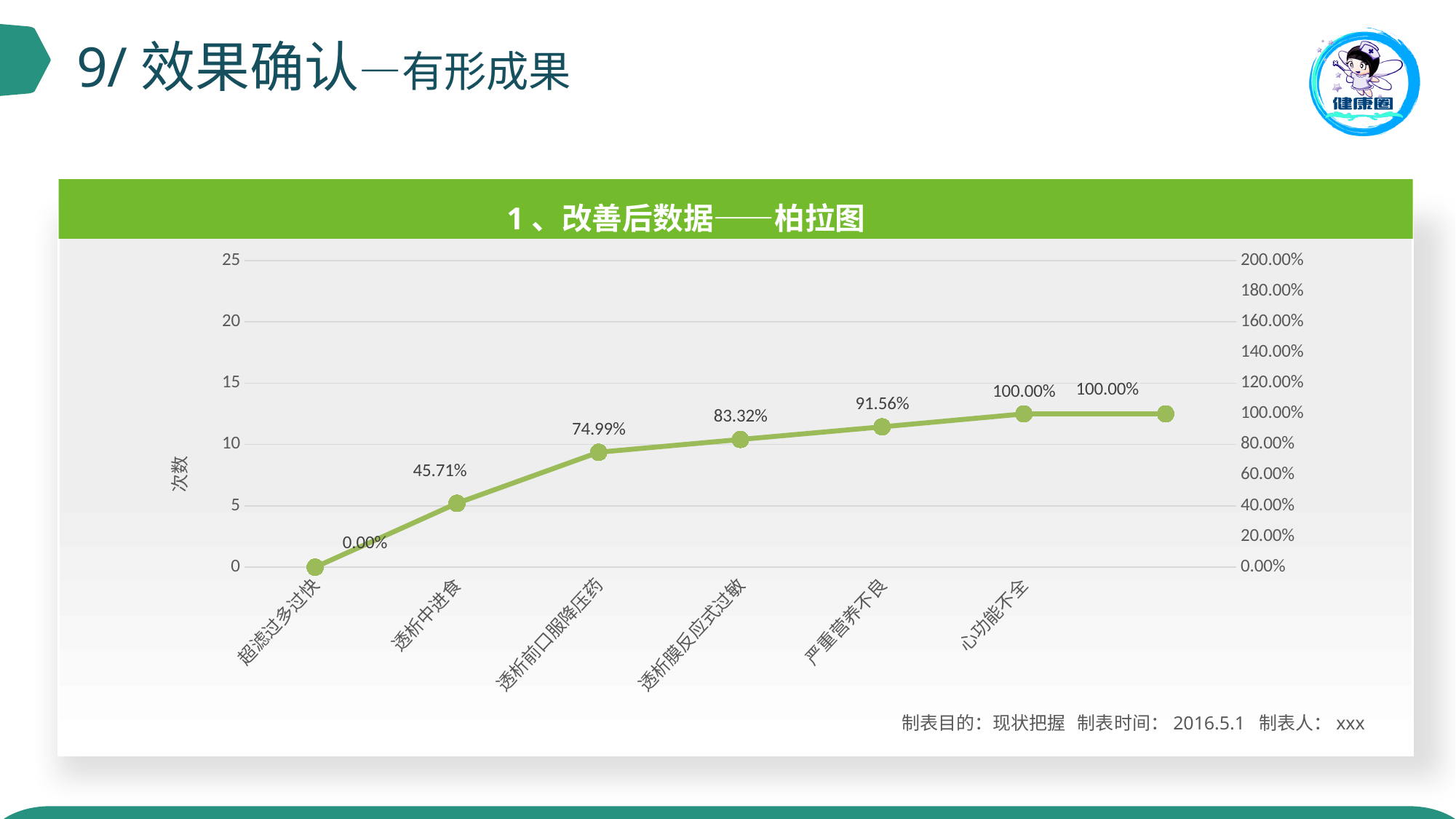
Which has a higher cumulative percentage, 透析膜反应式过敏 or 透析中进食? 透析膜反应式过敏 What is the difference between the cumulative percentages for 心功能不全 and 严重营养不良? 8.44% What is the difference between the cumulative percentages for 透析前口服降压药 and 透析中进食? 29.28% What is the cumulative percentage shown for 透析膜反应式过敏? 83.32% Which labelled category has the lowest cumulative percentage? 超滤过多过快 What is the cumulative percentage shown for 透析前口服降压药? 74.99% Do the plotted values rise or fall from left to right along the x axis? Rise What is the cumulative percentage shown for 心功能不全? 100.00% What is the cumulative percentage shown for 严重营养不良? 91.56% How many data points are plotted on the line? 7 What kind of chart is shown on the slide? Line chart What is the cumulative percentage shown for 透析中进食? 45.71%